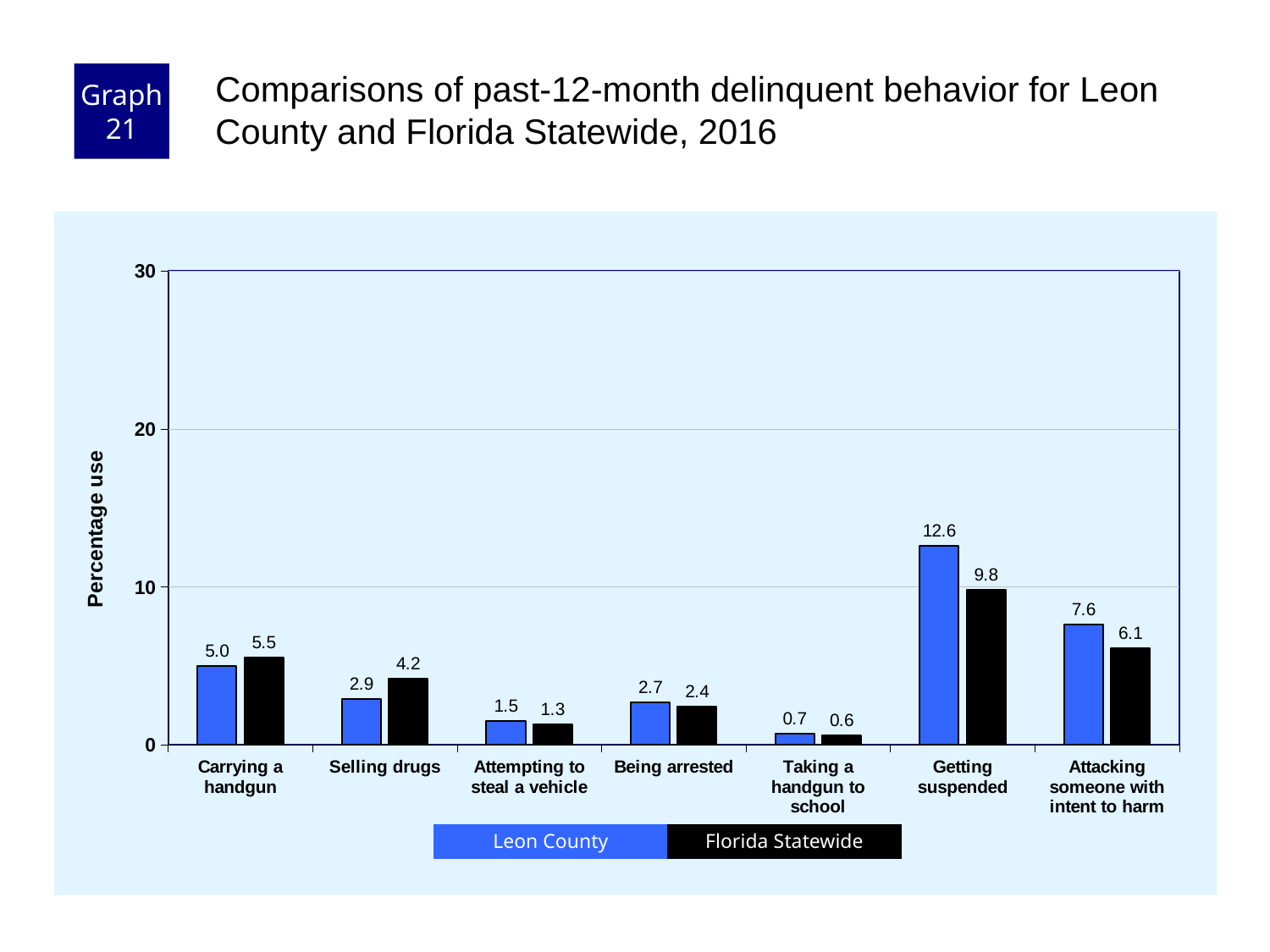
Which category has the highest Florida Statewide value? Getting suspended What is the Florida Statewide value for Selling drugs? 4.2 What is the Leon County value for Getting suspended? 12.6 How many categories are shown on the x axis? 7 What is the difference between the Leon County and Florida Statewide values for Getting suspended? 2.8 Which category has the lowest Leon County value? Taking a handgun to school What is the Leon County value for Taking a handgun to school? 0.7 Is the Leon County value for Getting suspended greater or less than 10? greater What is the difference between the Florida Statewide and Leon County values for Carrying a handgun? 0.5 What kind of chart is shown on the slide? bar chart How many series does the legend list? 2 Which is larger for Attacking someone with intent to harm: Leon County or Florida Statewide? Leon County